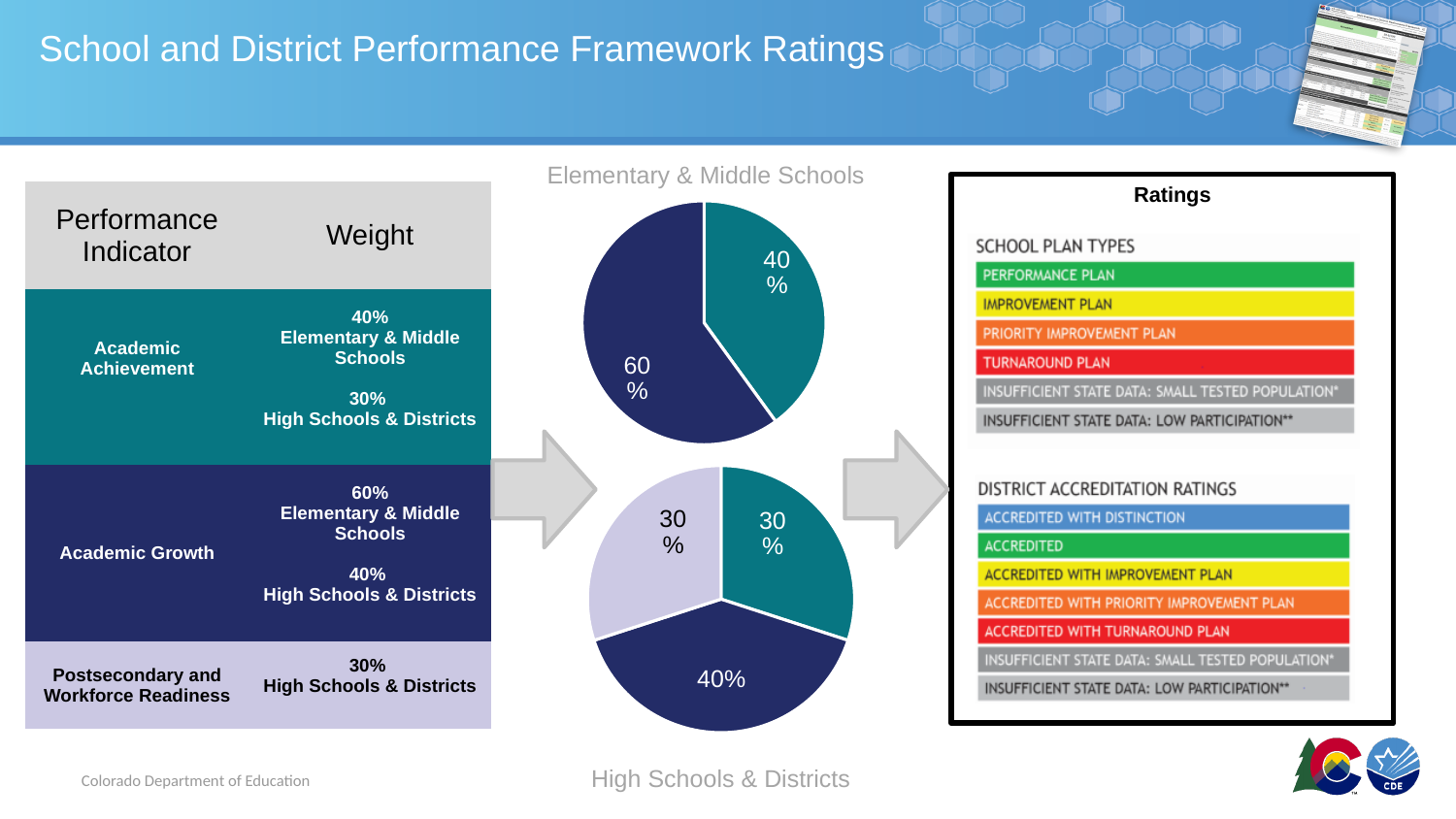
How many slices does the High Schools & Districts pie chart have? 3 In the Elementary & Middle Schools pie chart, what is the value of the largest slice? 60% In the High Schools & Districts pie chart, what is the value of the largest slice? 40% How many slices does the Elementary & Middle Schools pie chart have? 2 In the Elementary & Middle Schools pie chart, what value is shown on the teal slice? 40% In the High Schools & Districts pie chart, what value is shown on the dark blue slice? 40% What is the title of the pie chart at the bottom of the slide? High Schools & Districts What kind of chart is used for the Elementary & Middle Schools data? Pie chart In the High Schools & Districts pie chart, how many slices are labeled 30%? 2 In the Elementary & Middle Schools pie chart, what is the difference between the two slices? 20 percentage points Which is larger: the teal slice in the Elementary & Middle Schools pie chart or the teal slice in the High Schools & Districts pie chart? Elementary & Middle Schools In the Elementary & Middle Schools pie chart, what is the value of the smallest slice? 40%